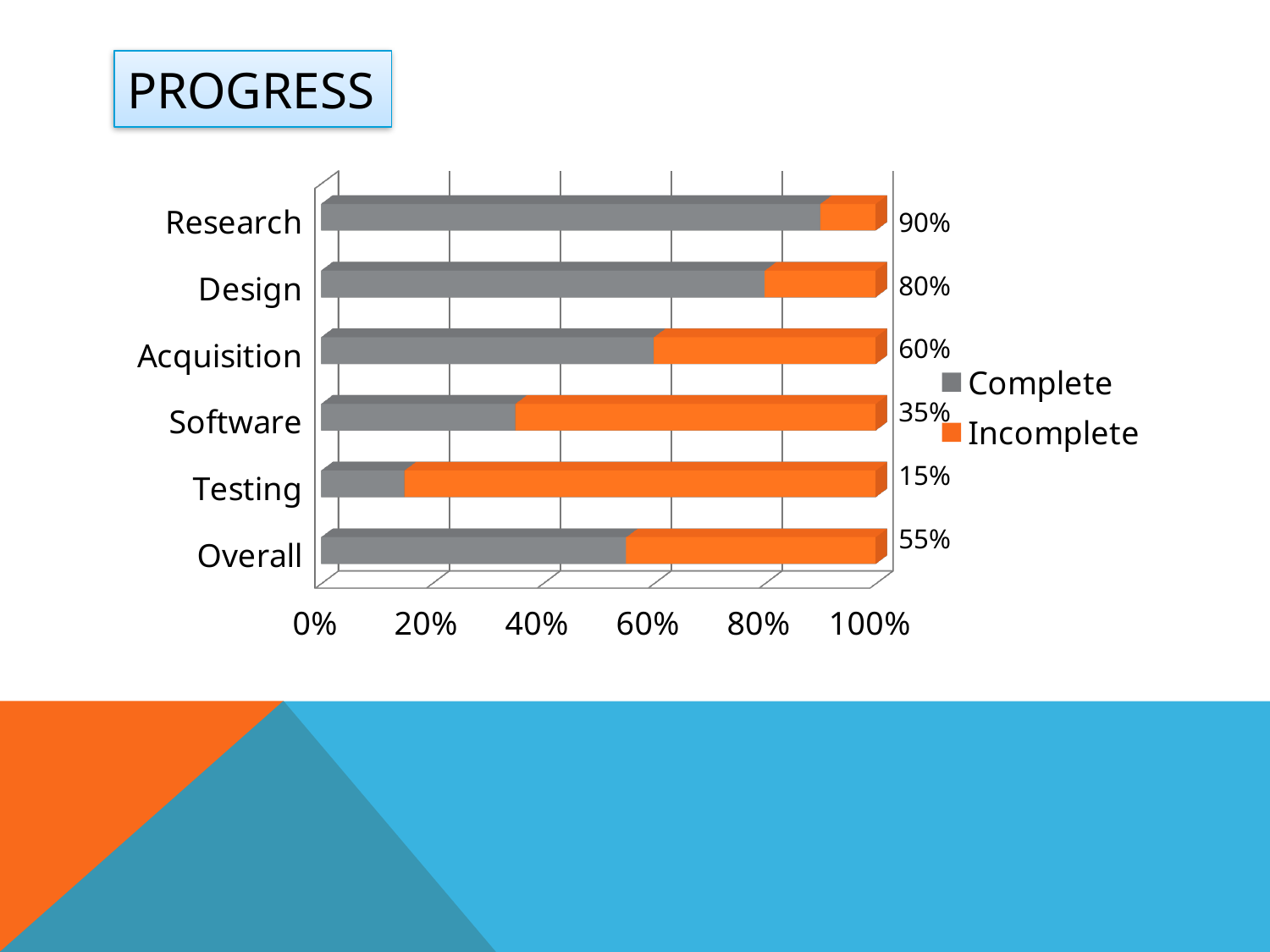
How many categories are shown on the chart? 6 Which colour represents the Incomplete series? Orange Which category has the lowest Complete percentage? Testing What kind of chart is shown on the slide? Stacked bar chart How many series does the legend list? 2 What is the difference between the Complete values for Design and Acquisition? 20% What is the Complete value for Overall? 55% Which category has the highest Complete percentage? Research Is the Complete value for Testing greater or less than 20%? less What is the Complete value for Research? 90% Which has a larger Complete value, Software or Overall? Overall What is the Complete value for Software? 35%